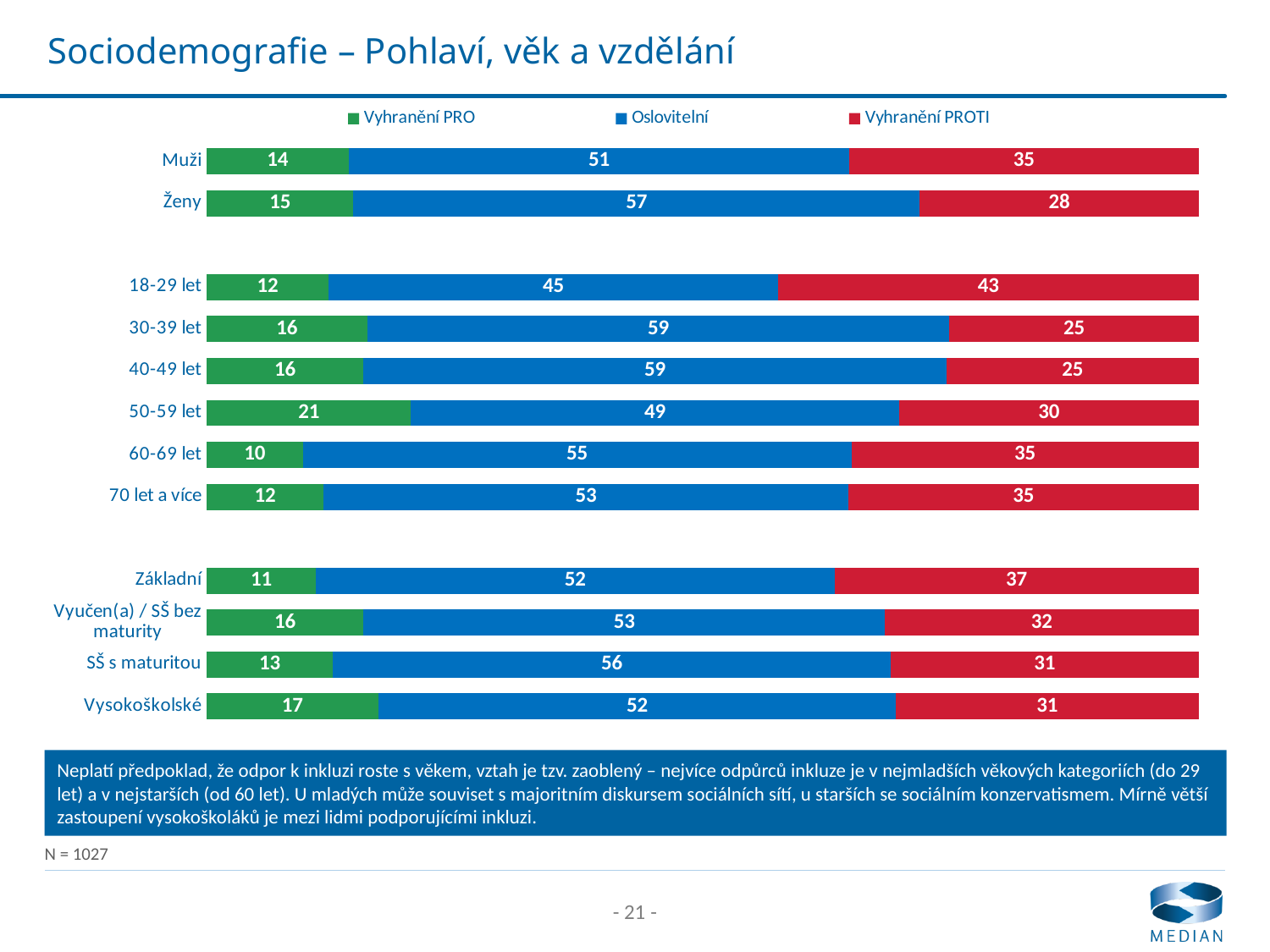
How many series does the legend list? 3 What is the difference between the Vyhranění PROTI values for Muži and Ženy? 7 What is the total of the stacked bar for Vysokoškolské? 100 Which is larger: the Oslovitelní value for Základní or for SŠ s maturitou? SŠ s maturitou Which category has the lowest Vyhranění PRO value? 60-69 let Which category has the highest Vyhranění PRO value? 50-59 let What is the value of Oslovitelní for Ženy? 57 What is the value of Vyhranění PRO for the 50-59 let category? 21 What kind of chart is shown on the slide? Stacked bar chart What is the value of Vyhranění PROTI for the 18-29 let category? 43 Which category has the highest Vyhranění PROTI value? 18-29 let How many categories are shown in the chart? 12